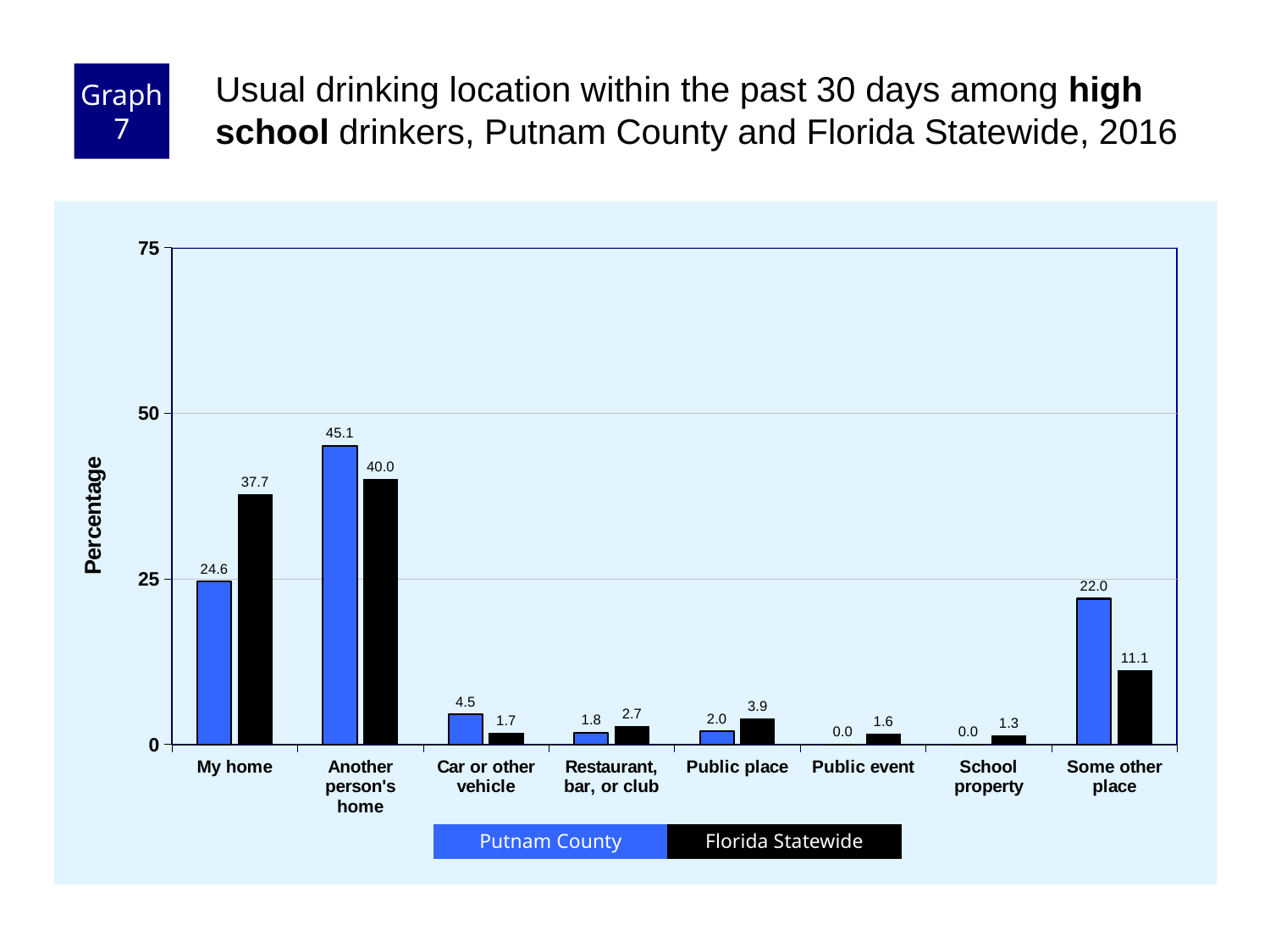
What kind of chart is shown on the slide? Bar chart How many series does the legend list? 2 What is the Putnam County value for "Another person's home"? 45.1 What is the difference between the Putnam County and Florida Statewide values for "My home"? 13.1 Is the Putnam County value for "Some other place" greater or less than 25? less What is the Florida Statewide value for "Some other place"? 11.1 What is the label of the y axis? Percentage Which category has the lowest Florida Statewide value? School property What is the Florida Statewide value for "My home"? 37.7 How many categories are shown on the x axis? 8 Which category has the highest Putnam County value? Another person's home Which is larger for "Public place": Putnam County or Florida Statewide? Florida Statewide